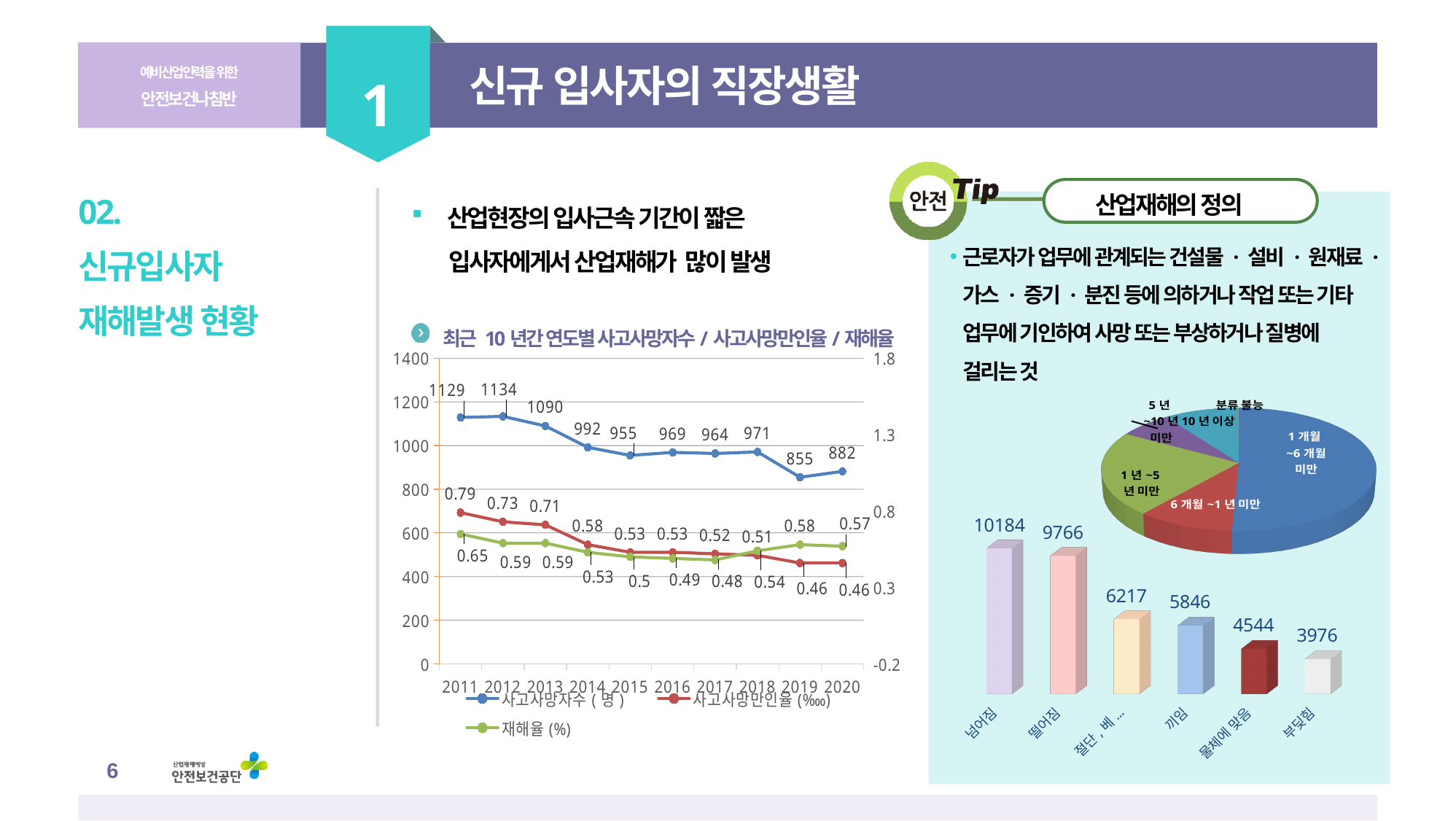
In the pie chart on the right side of the slide, which slice is the largest? 1개월~6개월 미만 In the line chart titled '최근 10년간 연도별 사고사망자수 / 사고사망만인율 / 재해율', what is the value of 사고사망자수 (명) for 2012? 1134 In the line chart titled '최근 10년간 연도별 사고사망자수 / 사고사망만인율 / 재해율', what is the 사고사망만인율 (‱) for 2014? 0.58 In the line chart titled '최근 10년간 연도별 사고사망자수 / 사고사망만인율 / 재해율', what is the 재해율 (%) for 2016? 0.49 In the line chart titled '최근 10년간 연도별 사고사망자수 / 사고사망만인율 / 재해율', which year has the lowest 사고사망자수 (명)? 2019 In the line chart titled '최근 10년간 연도별 사고사망자수 / 사고사망만인율 / 재해율', does the 사고사망만인율 (‱) generally rise or fall from 2011 to 2020? fall In the line chart titled '최근 10년간 연도별 사고사망자수 / 사고사망만인율 / 재해율', how many series does the legend list? 3 In the line chart titled '최근 10년간 연도별 사고사망자수 / 사고사망만인율 / 재해율', what is the difference in 사고사망자수 (명) between 2011 and 2020? 247 In the bar chart at the bottom right of the slide, which category has the lowest value? 부딪힘 In the bar chart at the bottom right of the slide, what is the difference between 떨어짐 and 끼임? 3920 In the bar chart at the bottom right of the slide, what is the value for 넘어짐? 10184 In the bar chart at the bottom right of the slide, how many categories are shown? 6